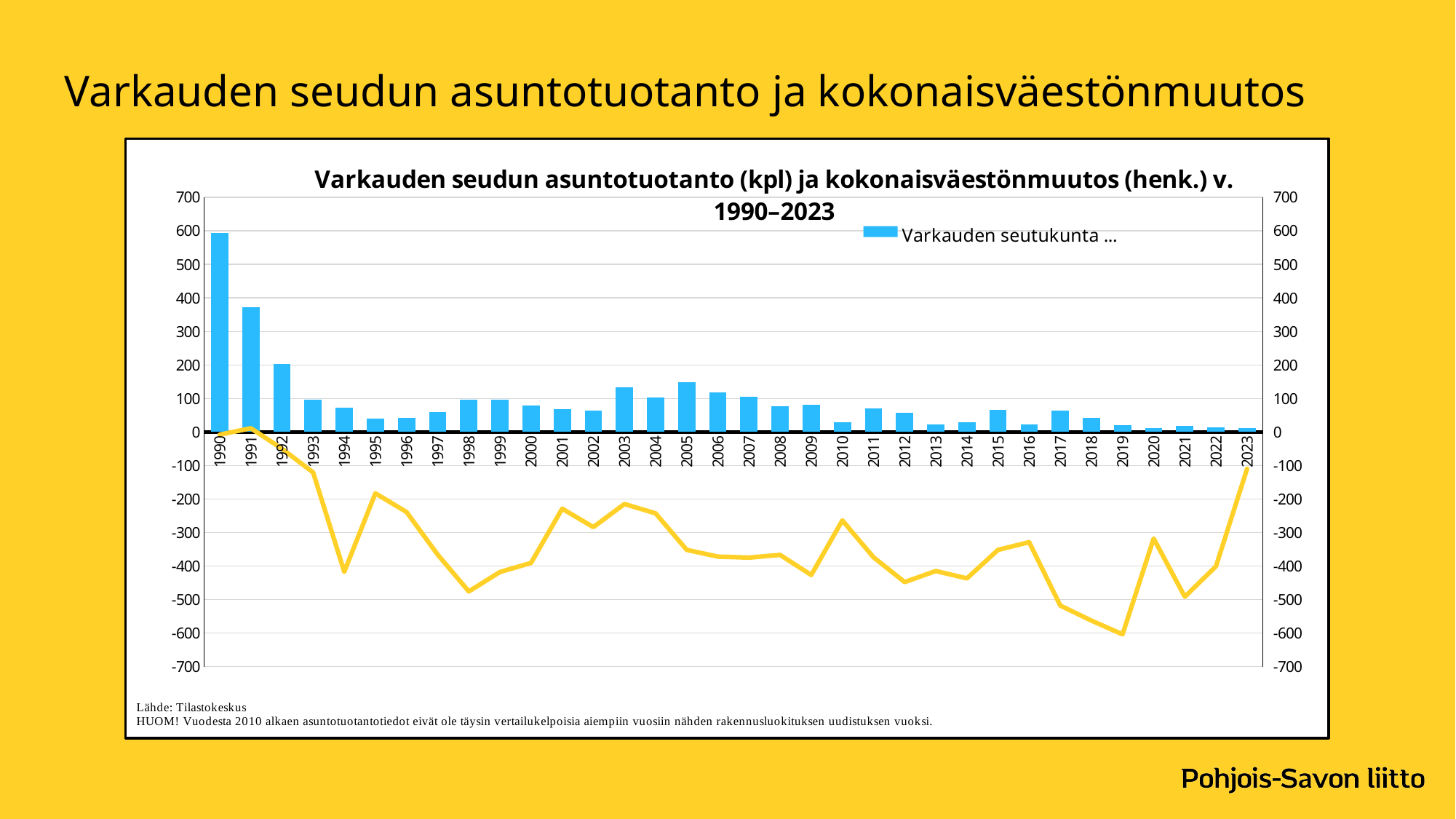
Is the housing production bar for 2005 greater or less than 100? greater What kind of chart is shown on the slide? A combined bar and line chart Do the housing production bars rise or fall from 1990 to 1993? fall Which year has the highest bar for housing production (asuntotuotanto)? 1990 How many years are plotted along the x axis of the chart? 34 Is the population change line value for 2023 greater or less than -200? greater Which year has the taller housing production bar, 2004 or 2005? 2005 Is the housing production bar for 1991 greater or less than 400? less In which year does the population change line reach its lowest point? 2019 What is the source (Lähde) given below the chart? Tilastokeskus